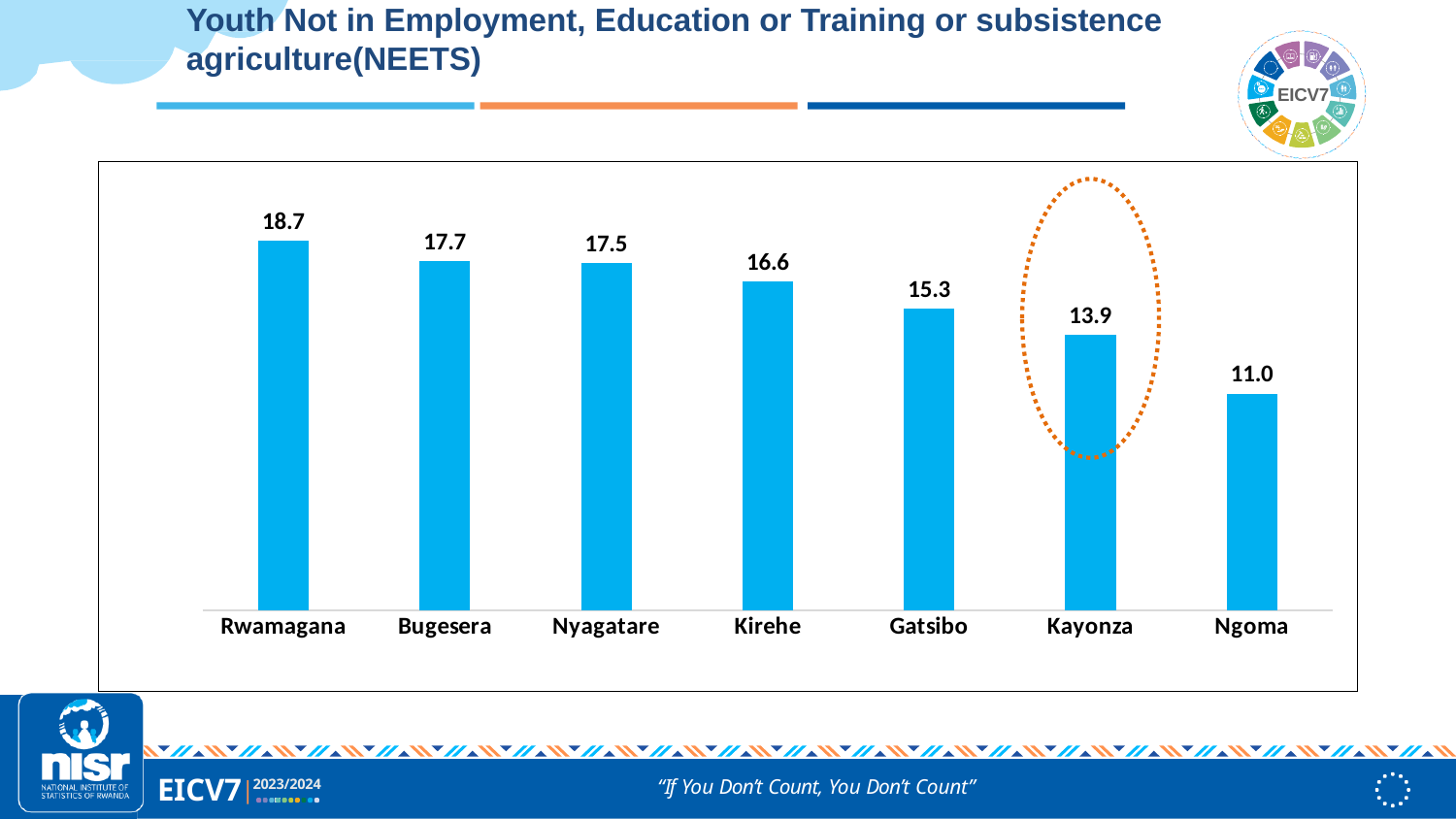
Which district has the highest value? Rwamagana What kind of chart is shown on the slide? bar chart What is the value for Rwamagana? 18.7 Which is larger, the value for Bugesera or the value for Gatsibo? Bugesera What is the value for Gatsibo? 15.3 Which district has the lowest value? Ngoma Do the values rise or fall from left to right across the districts? fall How many districts are shown in the chart? 7 What is the value for Kayonza? 13.9 What is the difference between the values for Kirehe and Kayonza? 2.7 What is the difference between the values for Rwamagana and Ngoma? 7.7 Which district's bar is circled with a dotted orange outline? Kayonza